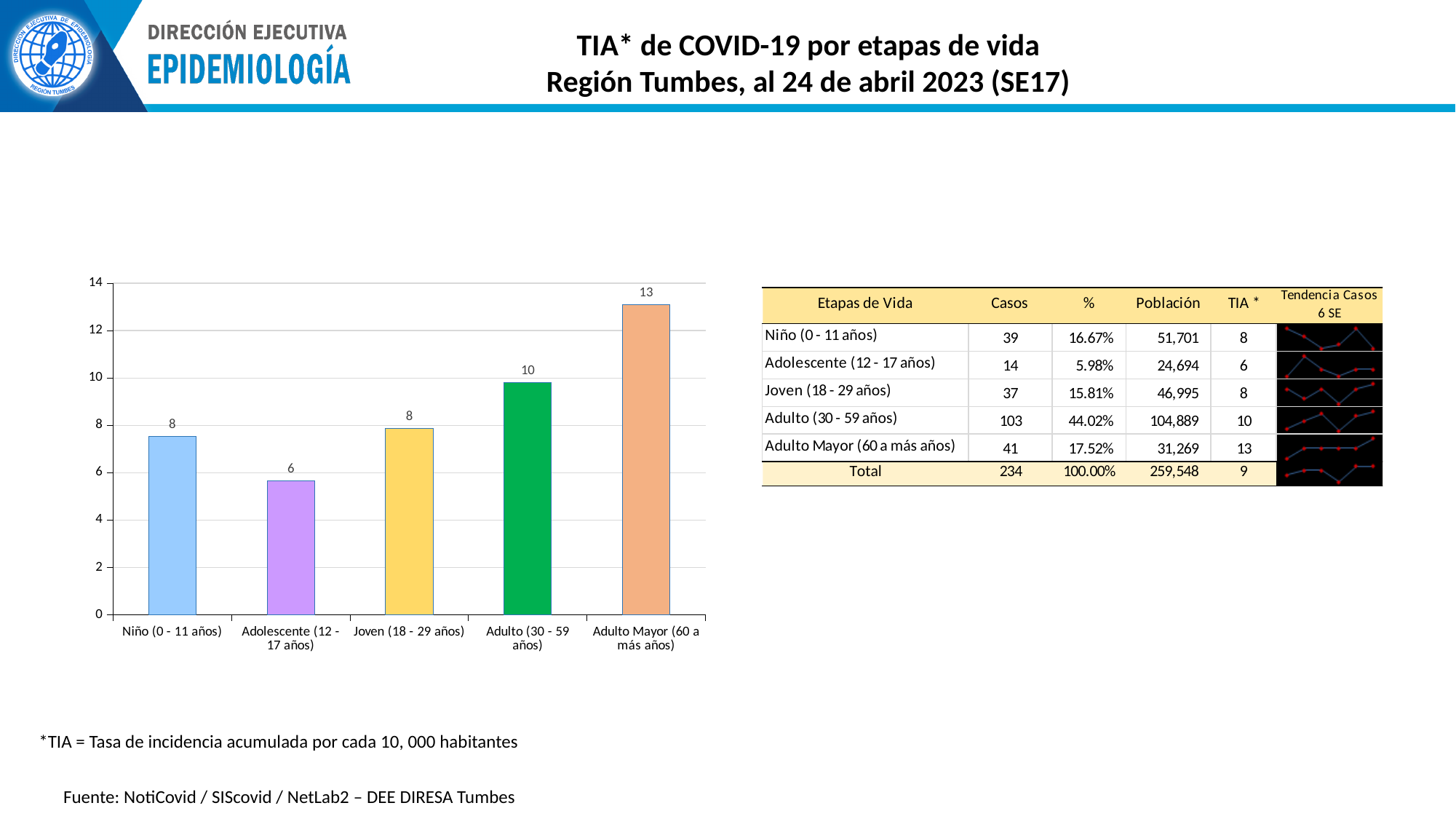
What is the difference between the TIA labels for Adulto (30 - 59 años) and Joven (18 - 29 años)? 2 What is the TIA value shown for Adolescente (12 - 17 años)? 6 Which life stage has the lowest TIA in the bar chart? Adolescente (12 - 17 años) How many life-stage categories are shown in the bar chart? 5 Is the value for Adulto Mayor (60 a más años) greater or less than 12? greater What colour is the bar for Adulto (30 - 59 años)? Green Which life stage has the highest TIA in the bar chart? Adulto Mayor (60 a más años) What is the TIA value shown for Adulto (30 - 59 años)? 10 Which has a larger TIA, Adulto (30 - 59 años) or Adolescente (12 - 17 años)? Adulto (30 - 59 años) What kind of chart is used to show the TIA by life stage? Bar chart What is the TIA value shown for Adulto Mayor (60 a más años)? 13 What is the difference between the TIA labels for Adulto Mayor (60 a más años) and Adolescente (12 - 17 años)? 7